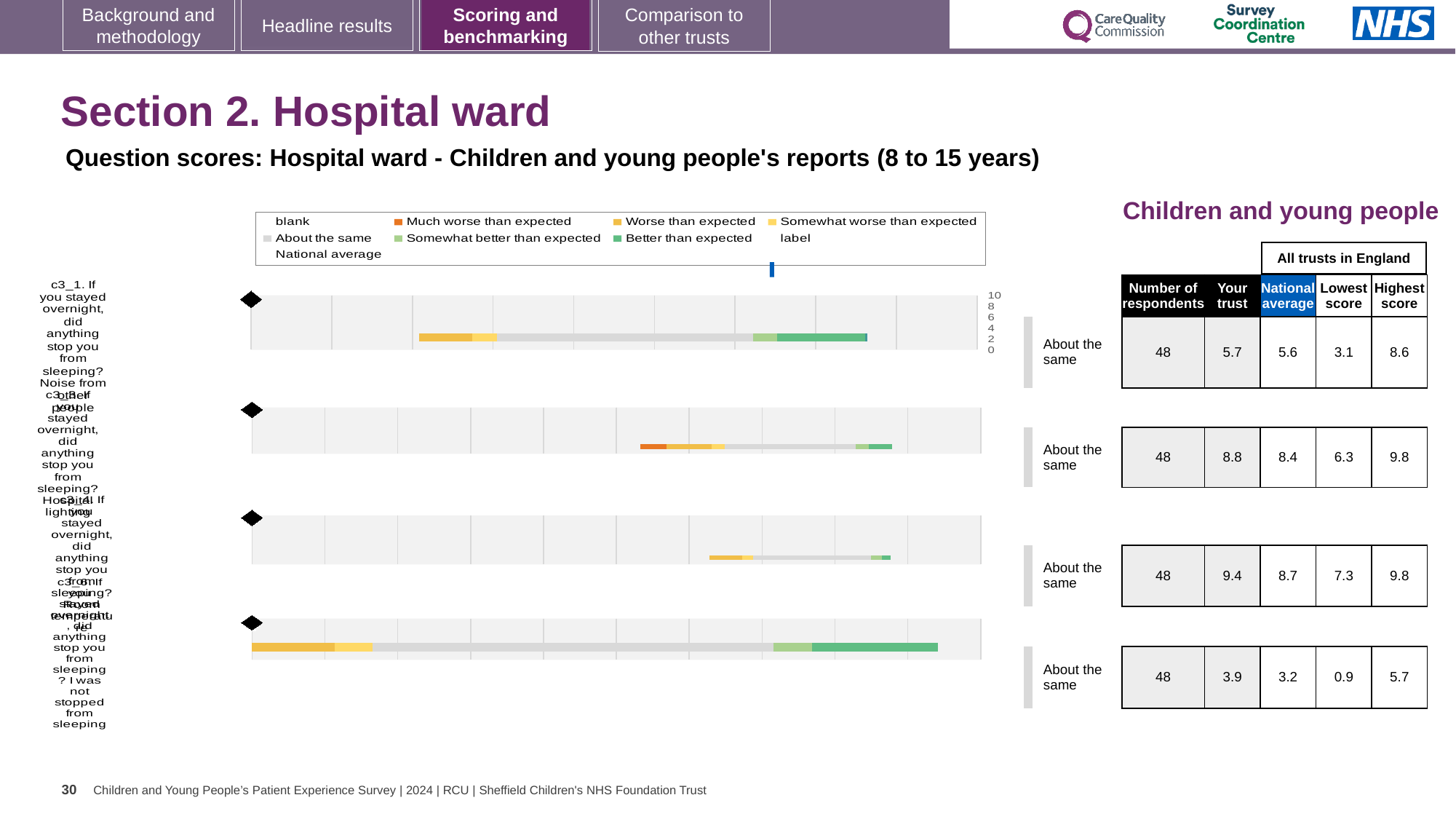
Which row in the table beside the chart has the lowest 'Your trust' score? the fourth row (3.9) In the table beside the chart, what is the 'Your trust' score for the first row? 5.7 In the table beside the chart, how many respondents are listed for each row? 48 In the chart legend, what colour represents 'Much worse than expected'? orange What kind of chart is shown on the slide? bar chart In the chart legend, what colour represents 'Better than expected'? green Which row in the table beside the chart has the highest 'Your trust' score? the third row (9.4) In the table beside the chart, what is the difference between the highest score and the lowest score for the fourth row? 4.8 In the table beside the chart, for the second row, which is larger: the 'Your trust' score or the national average? Your trust (8.8) In the table beside the chart, what is the national average for the third row? 8.7 How many horizontal bars are plotted in the chart? 4 In the table beside the chart, what is the difference between the 'Your trust' score and the national average for the third row? 0.7